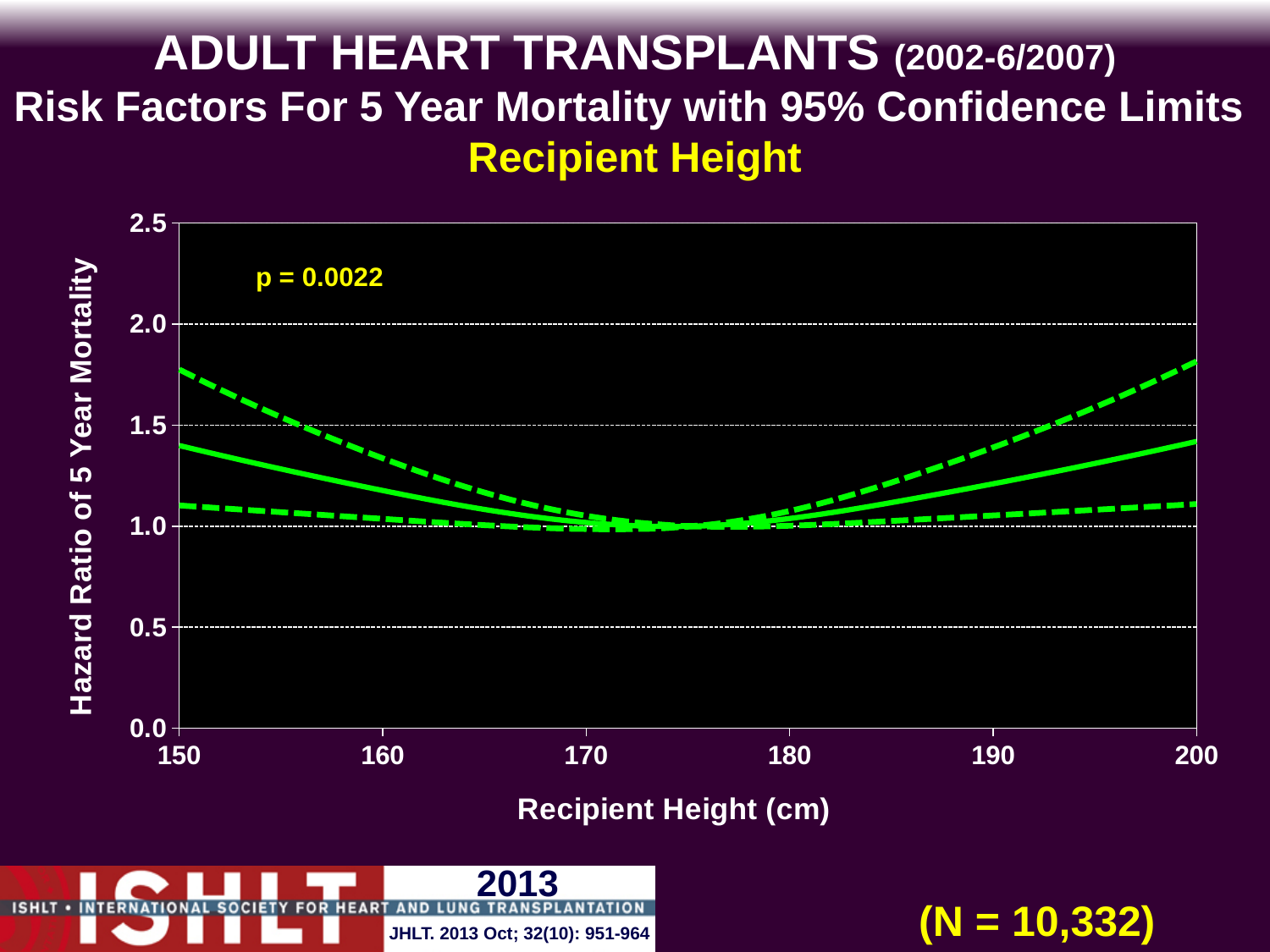
What kind of chart is shown on the slide? line chart Is the upper confidence limit (upper dashed line) at a recipient height of 150 cm greater or less than 1.5? greater Is the lower confidence limit (lower dashed line) at a recipient height of 200 cm greater or less than 1.5? less What p-value is shown on the chart? p = 0.0022 Does the hazard ratio (solid line) rise or fall as recipient height increases from 150 cm to 170 cm? fall Does the hazard ratio (solid line) rise or fall as recipient height increases from 180 cm to 200 cm? rise Is the hazard ratio (solid line) at a recipient height of 150 cm greater or less than 1.5? less Which is larger, the hazard ratio (solid line) at 150 cm or at 175 cm? 150 cm How many lines are plotted on the chart? 3 What is the sample size (N) shown on the slide? N = 10,332